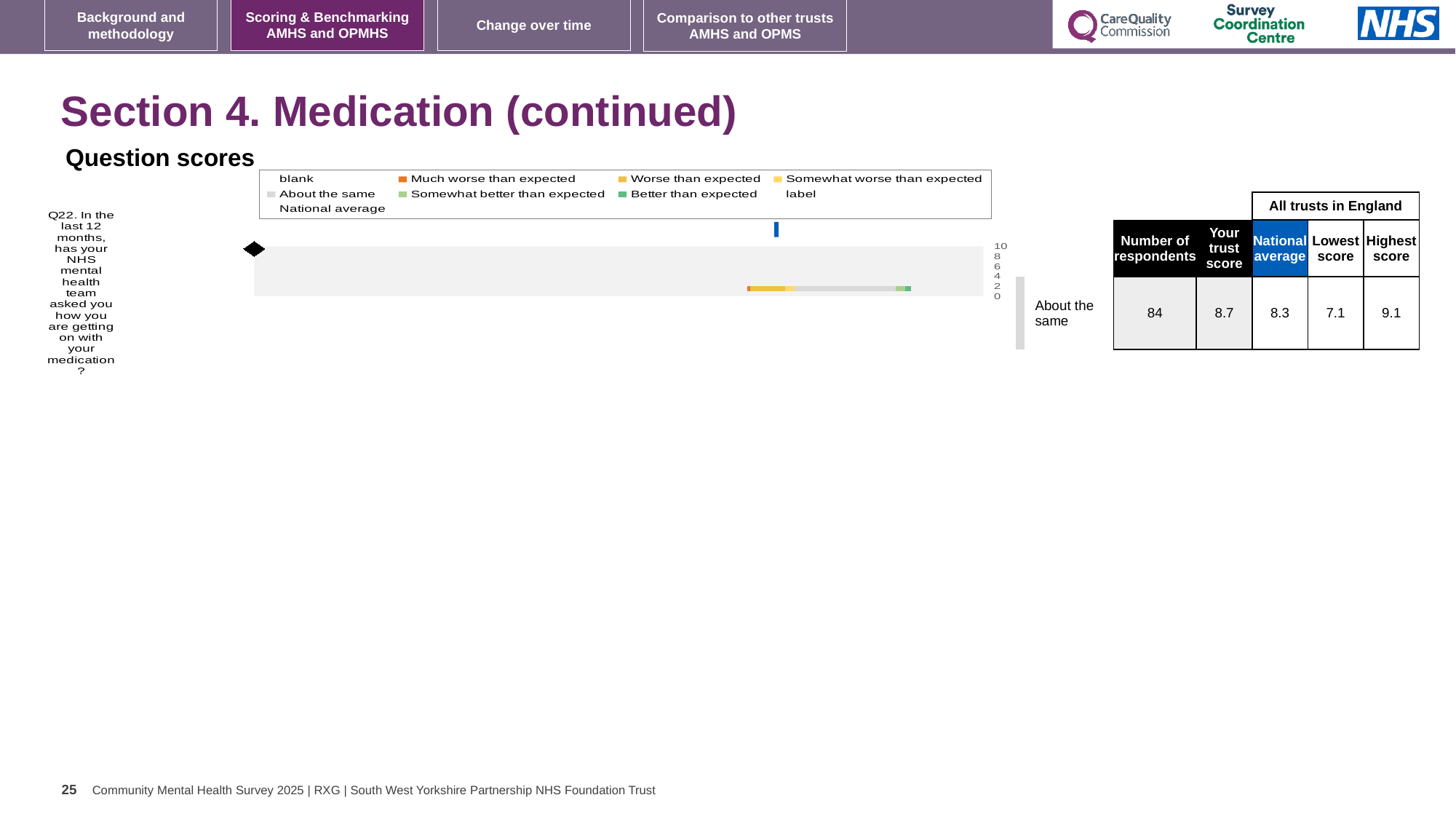
How many respondents answered Q22? 84 How many questions are plotted in the Question scores chart? 1 What is the national average for Q22? 8.3 What kind of chart is shown under 'Question scores'? bar chart What is the difference between the trust's score and the national average for Q22? 0.4 What is the highest score among all trusts in England for Q22? 9.1 What benchmark category is the trust's Q22 score placed in? About the same Is the trust's score for Q22 higher or lower than the national average? higher What is the lowest score among all trusts in England for Q22? 7.1 What is the trust's score for Q22 shown next to the chart? 8.7 Which question is plotted in the Question scores chart? Q22. In the last 12 months, has your NHS mental health team asked you how you are getting on with your medication? What is the difference between the highest and lowest scores among all trusts for Q22? 2.0